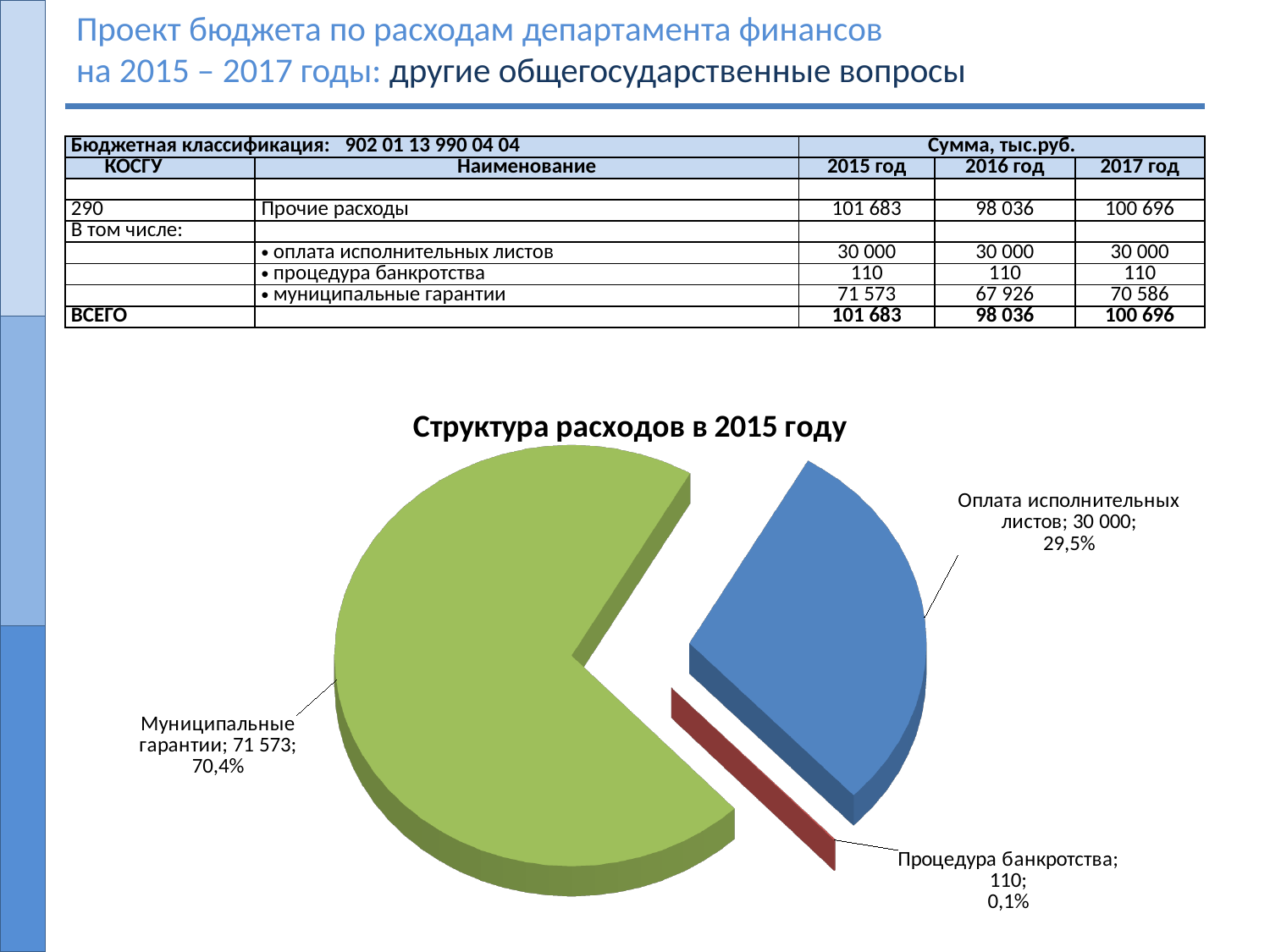
Which is larger: Оплата исполнительных листов or Процедура банкротства? Оплата исполнительных листов What is the title of the chart? Структура расходов в 2015 году Which slice of the pie chart is the smallest? Процедура банкротства What kind of chart is shown on the slide? pie chart What is the value for Оплата исполнительных листов in the pie chart? 30 000 What share of the pie does Оплата исполнительных листов represent? 29,5% What is the value for Муниципальные гарантии in the pie chart? 71 573 What is the value for Процедура банкротства in the pie chart? 110 What is the difference between the values for Муниципальные гарантии and Оплата исполнительных листов? 41 573 What share of the pie does Муниципальные гарантии represent? 70,4% Which slice of the pie chart is the largest? Муниципальные гарантии How many slices does the pie chart have? 3